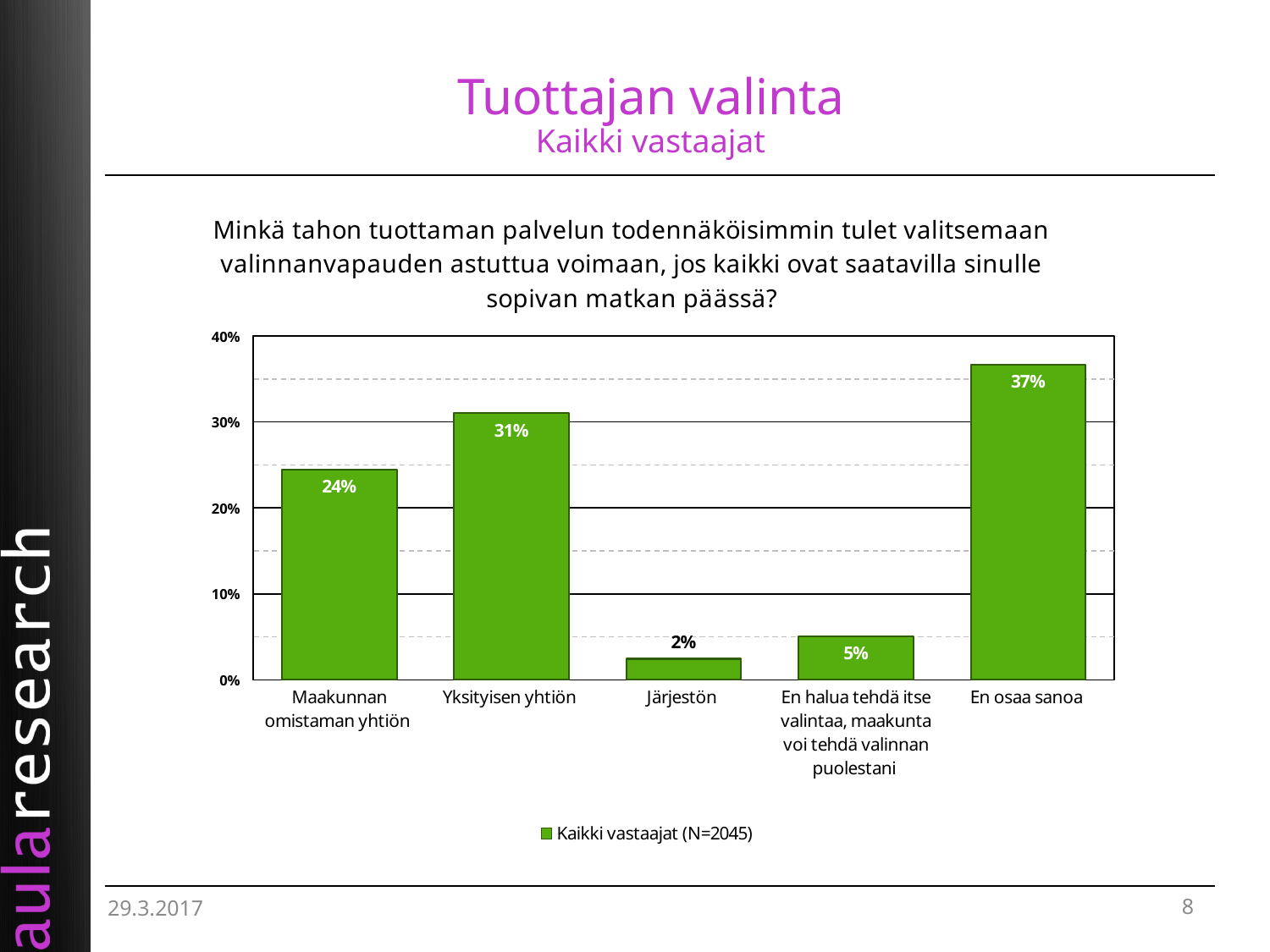
What is the legend entry for the series shown? Kaikki vastaajat (N=2045) What is the value for Järjestön? 2% What kind of chart is shown on the slide? bar chart What is the difference between the values for En osaa sanoa and Maakunnan omistaman yhtiön? 13% Is the value for Maakunnan omistaman yhtiön greater or less than 20%? greater Which category has the lowest value? Järjestön How many series does the legend list? 1 Which category has the highest value? En osaa sanoa How many categories are shown on the x axis? 5 Which is larger, the value for Yksityisen yhtiön or the value for Maakunnan omistaman yhtiön? Yksityisen yhtiön What is the value for En osaa sanoa? 37% What is the value for Yksityisen yhtiön? 31%